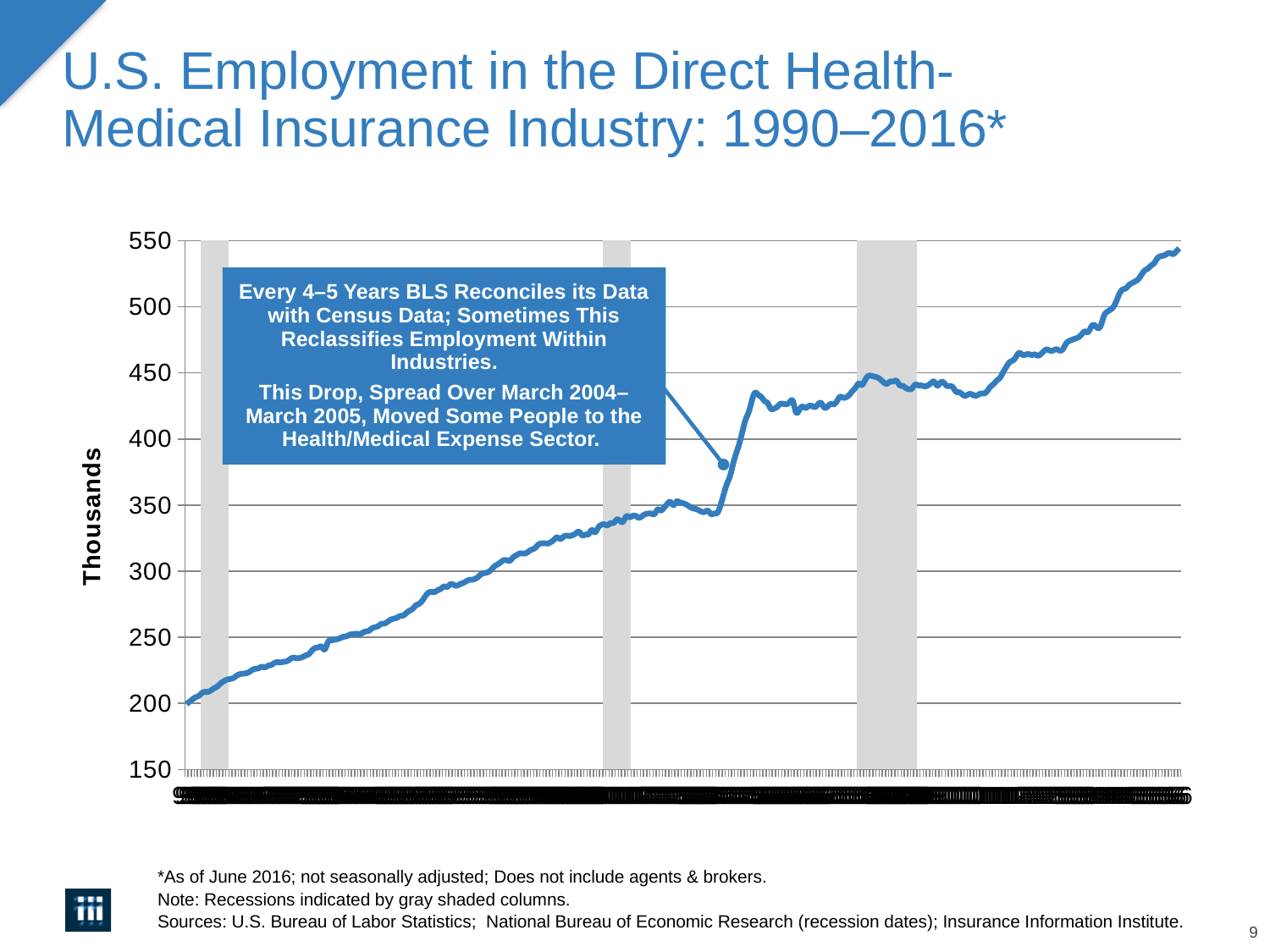
Does the line reach its highest value at the left end or the right end of the chart? right end Is the value at the marked drop point (March 2004–March 2005) greater or less than 400? less Which is larger: the value at the right end of the line or the value at the left end of the line? the value at the right end What is the highest value shown on the vertical axis of the chart? 550 Is the value at the right (end) of the line greater or less than 500? greater Does the line reach its lowest value at the left end or the right end of the chart? left end Overall, does the line rise or fall from the left end of the x axis to the right end? rise What kind of chart is shown on the slide? line chart What is the title of the chart on the slide? U.S. Employment in the Direct Health-Medical Insurance Industry: 1990–2016* Is the value at the left (start) end of the line greater or less than 150? greater What is the label on the vertical axis of the chart? Thousands